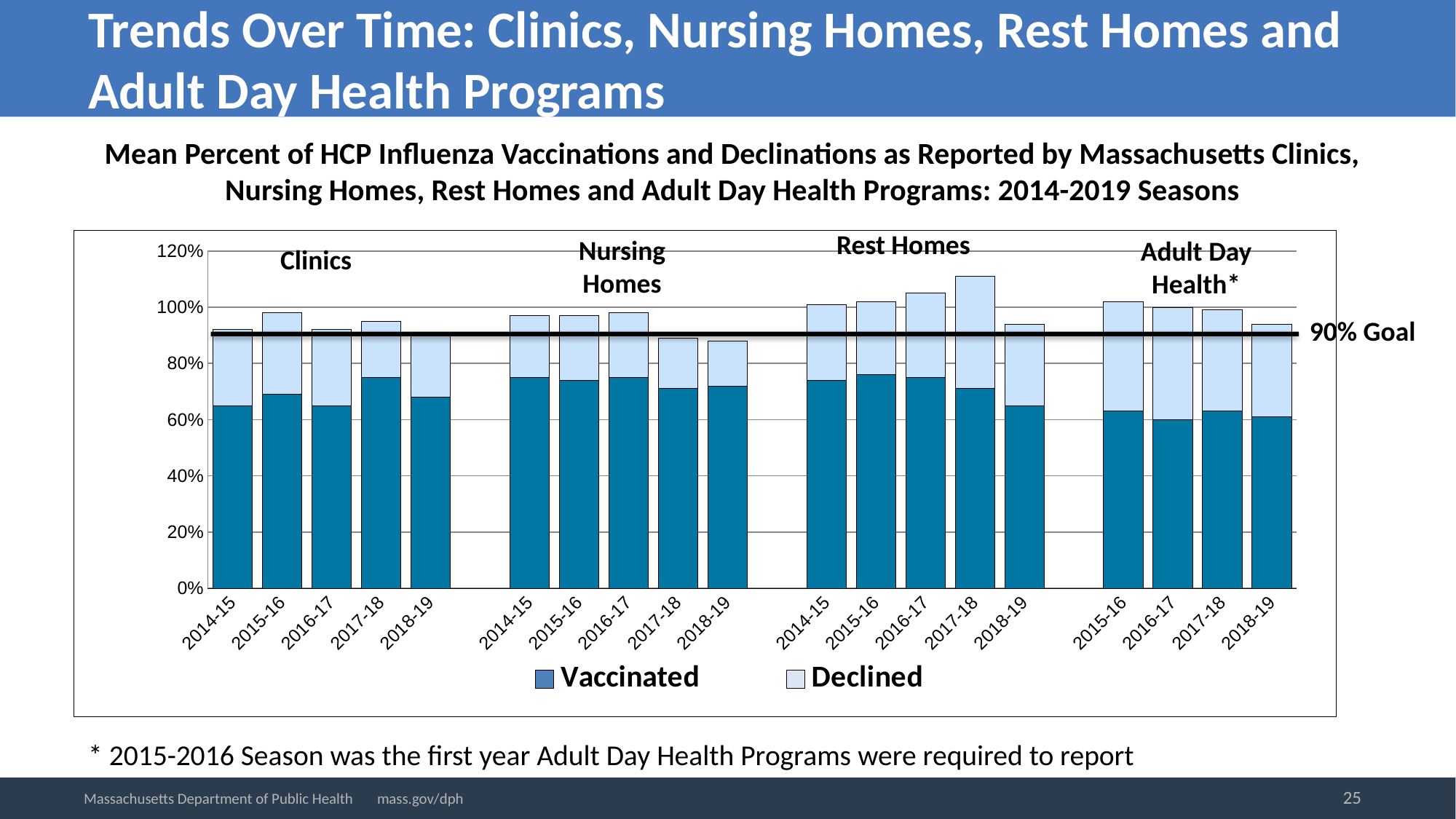
Which bar has the highest total (Vaccinated plus Declined) on the chart? Rest Homes 2017-18 What goal level does the horizontal black line mark? 90% Goal How many seasons are plotted for Adult Day Health? 4 Within the Clinics group, which season has the highest Vaccinated value? 2017-18 What are the two series named in the legend? Vaccinated and Declined Within the Rest Homes group, which season has the lowest Vaccinated value? 2018-19 How many series does the legend list? 2 How many facility-type groups are shown along the x axis? 4 What kind of chart is shown on the slide? Stacked bar chart Is the Vaccinated value for Clinics in 2017-18 greater or less than 70%? greater Is the Vaccinated value for Adult Day Health in 2016-17 greater or less than 70%? less Within Rest Homes, does the Vaccinated value rise or fall from 2016-17 to 2018-19? fall